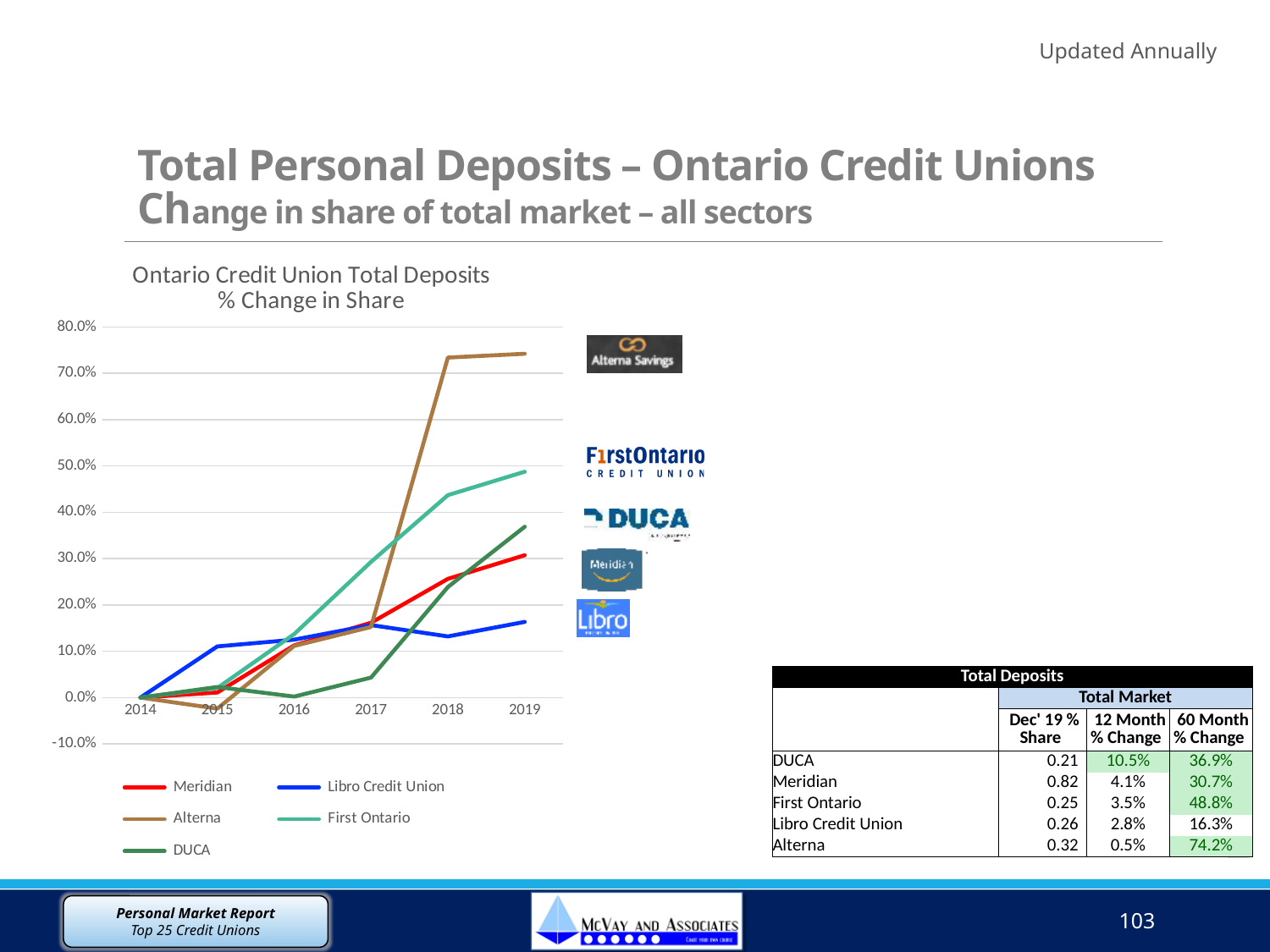
Is the value for First Ontario in 2019 greater or less than 40.0%? greater How many series does the chart legend list? 5 Is the value for DUCA in 2019 greater or less than 30.0%? greater Does the Alterna line rise or fall between 2017 and 2018? rise Is the value for Alterna in 2019 greater or less than 70.0%? greater What is the title of the chart? Ontario Credit Union Total Deposits % Change in Share Which credit union has the lowest value in 2019? Libro Credit Union What kind of chart is shown on the slide? line chart Which credit union has the highest value in 2019? Alterna How many years are shown on the x axis of the chart? 6 In 2019, which is larger: the value for DUCA or the value for Meridian? DUCA